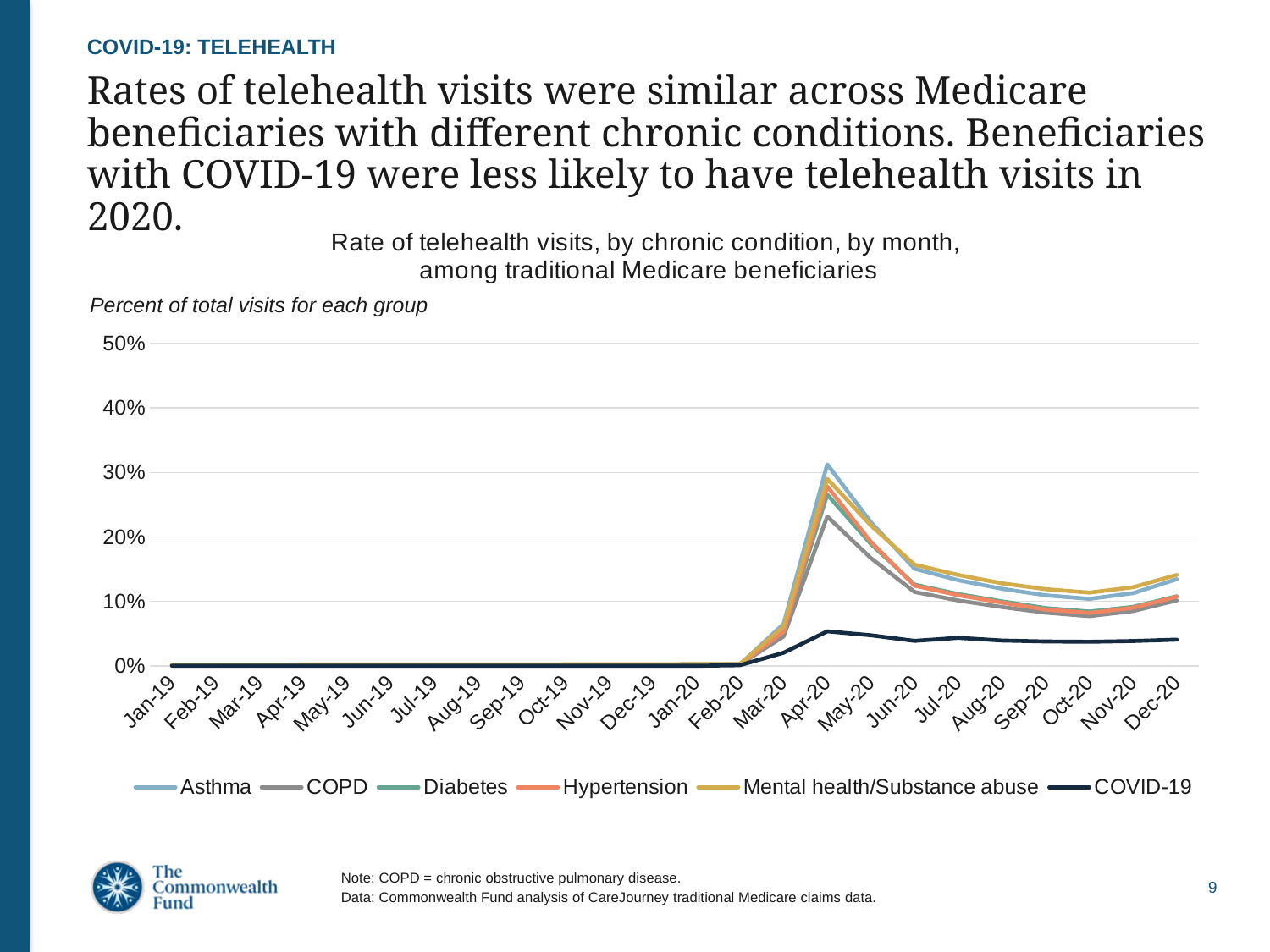
Is the value for COVID-19 in Apr-20 greater or less than 10%? less What does the y axis measure, according to the label above the chart? Percent of total visits for each group Is the value for Asthma in Apr-20 greater or less than 20%? greater Do the values for Asthma rise or fall from Apr-20 to Oct-20? Fall Is the value for COPD in Apr-20 greater or less than 20%? greater Which is larger in Apr-20, the value for Asthma or the value for COVID-19? Asthma What kind of chart is shown on the slide? Line chart How many months are plotted along the x axis? 24 Which series has the lowest value in Apr-20? COVID-19 What is the first month shown on the x axis? Jan-19 Which series has the highest value in Apr-20? Asthma How many series does the legend list? 6